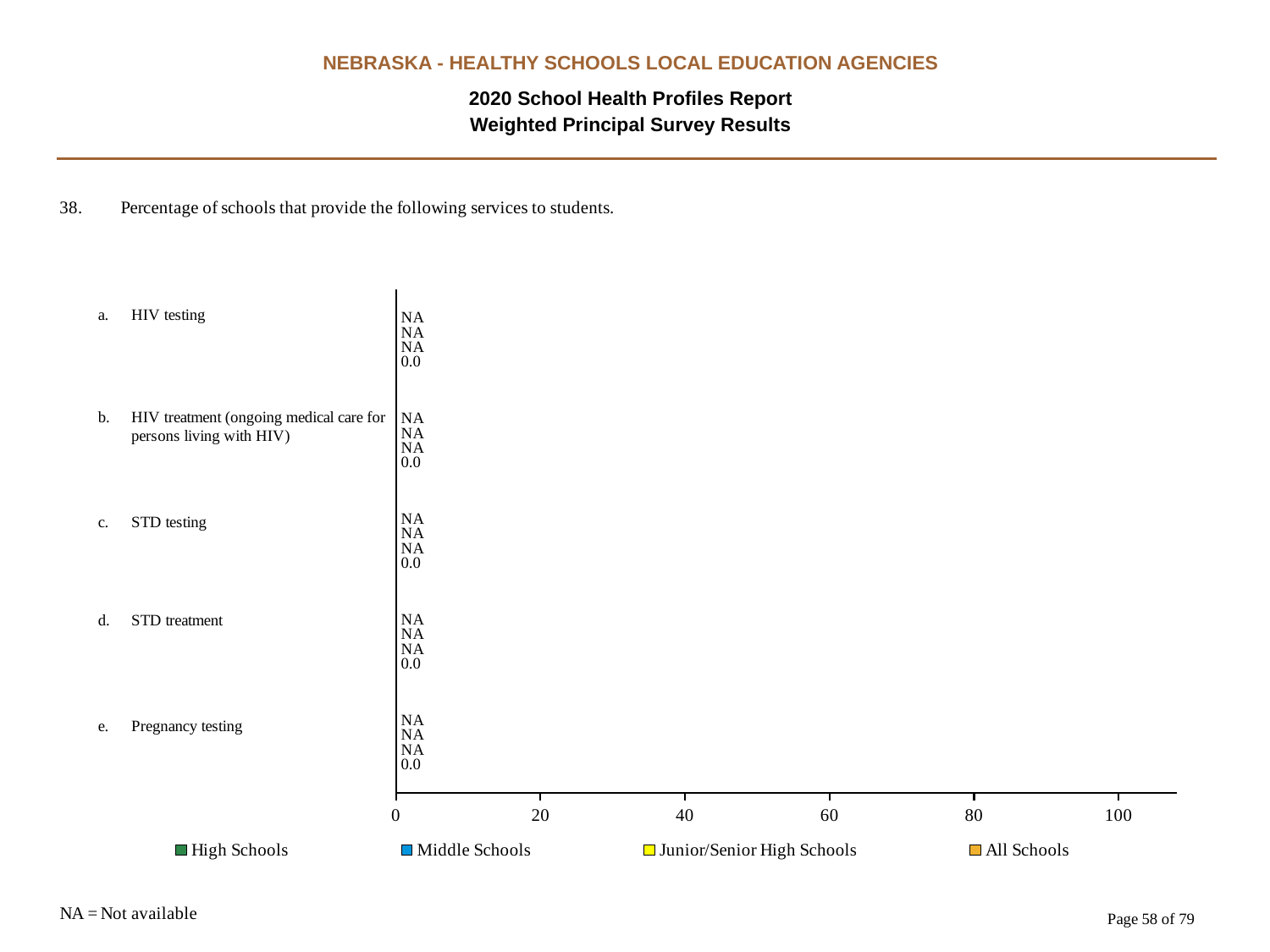
What kind of chart is shown on the slide? Bar chart What is the value for Middle Schools for STD treatment? NA How many series does the legend list? 4 What is the value for Junior/Senior High Schools for HIV treatment (ongoing medical care for persons living with HIV)? NA How many service categories are listed in the chart? 5 What is the value for All Schools for STD treatment? 0.0 What is the highest value shown on the x axis? 100 What does NA stand for according to the note on the slide? Not available What is the value for All Schools for HIV testing? 0.0 What is the value for All Schools for Pregnancy testing? 0.0 What is the value for High Schools for STD testing? NA